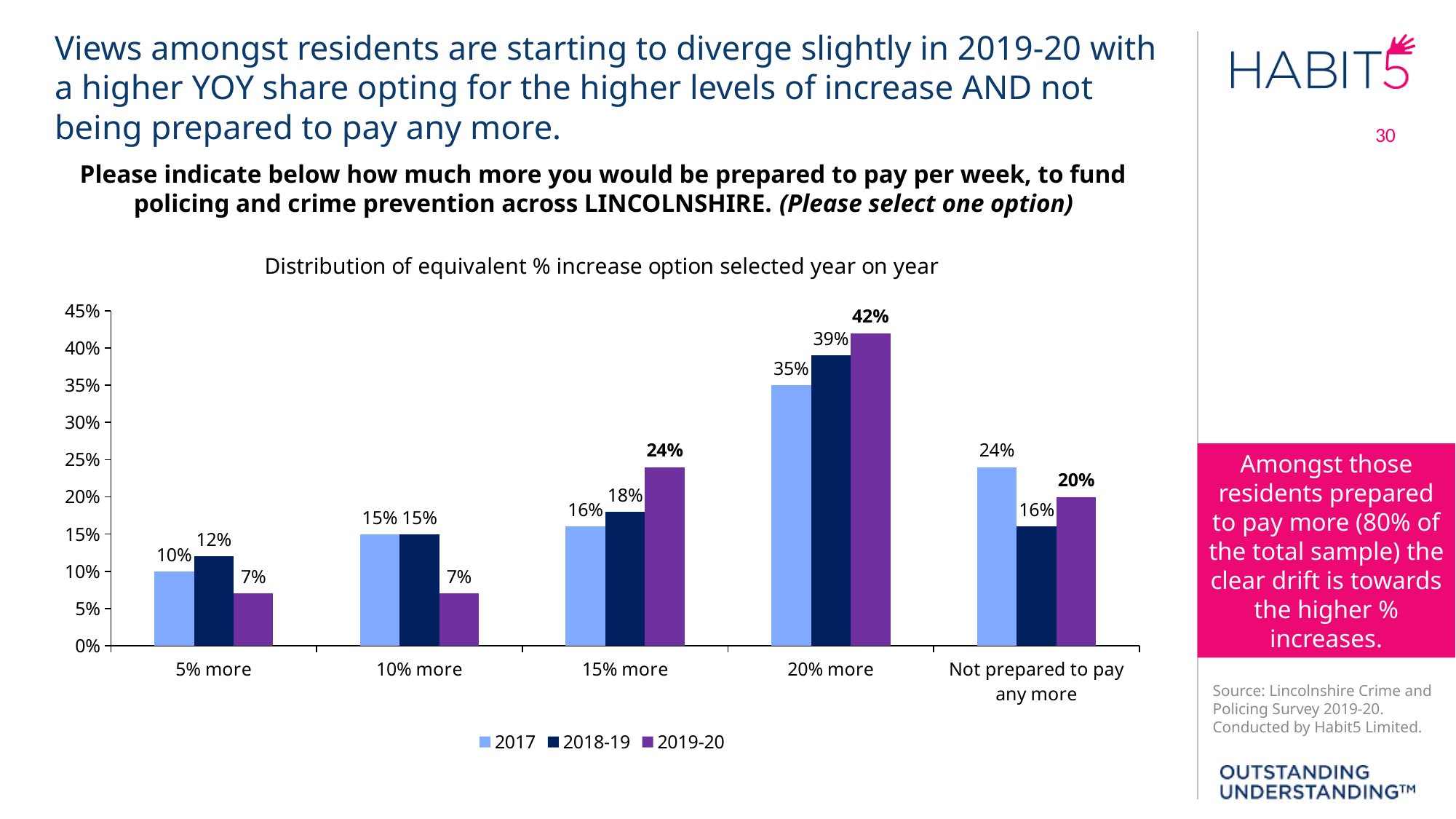
What is the value for 2019-20 in the "20% more" category? 42% Which is larger in the "15% more" category: the 2018-19 value or the 2019-20 value? 2019-20 What is the value for 2017 in the "Not prepared to pay any more" category? 24% Which category has the highest value for the 2019-20 series? 20% more Which category has the lowest value for the 2017 series? 5% more How many series does the legend list? 3 What is the difference between the 2019-20 and 2017 values in the "20% more" category? 7% What kind of chart is shown on the slide? Bar chart How many categories are shown on the x axis? 5 What is the value for 2018-19 in the "5% more" category? 12% What is the value for 2019-20 in the "10% more" category? 7% What is the title of the chart? Distribution of equivalent % increase option selected year on year